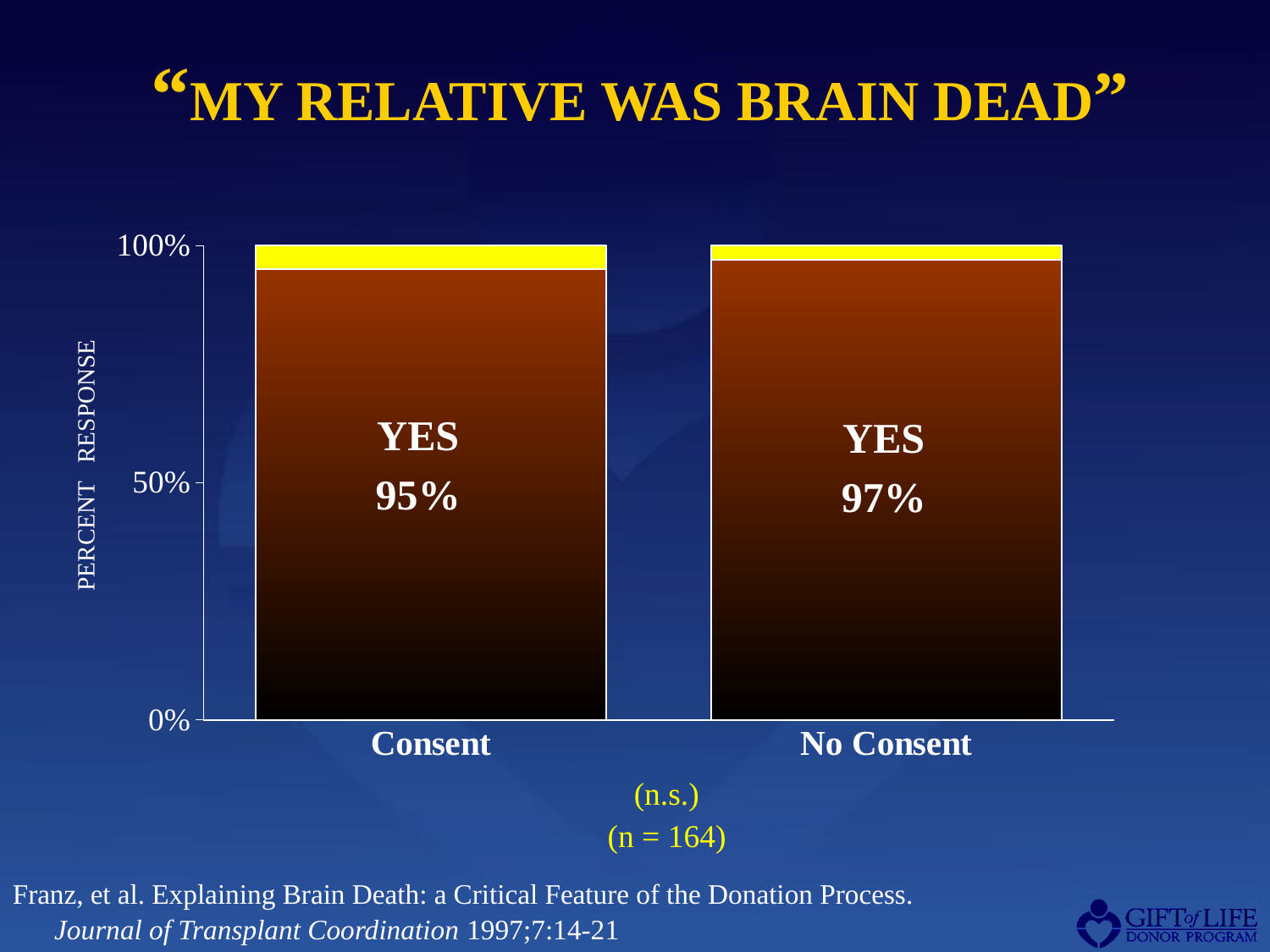
What is the title of the slide? "MY RELATIVE WAS BRAIN DEAD" Is the YES percentage larger for Consent or for No Consent? No Consent Is the YES value for Consent greater or less than 50%? greater How many categories are shown on the x axis? 2 Which group has the lower YES percentage? Consent What is the difference between the YES percentages for No Consent and Consent? 2% Which group has the higher YES percentage? No Consent What percentage of the Consent group answered YES? 95% What kind of chart is shown on the slide? Bar chart What is the label on the y axis? PERCENT RESPONSE What percentage of the No Consent group answered YES? 97%